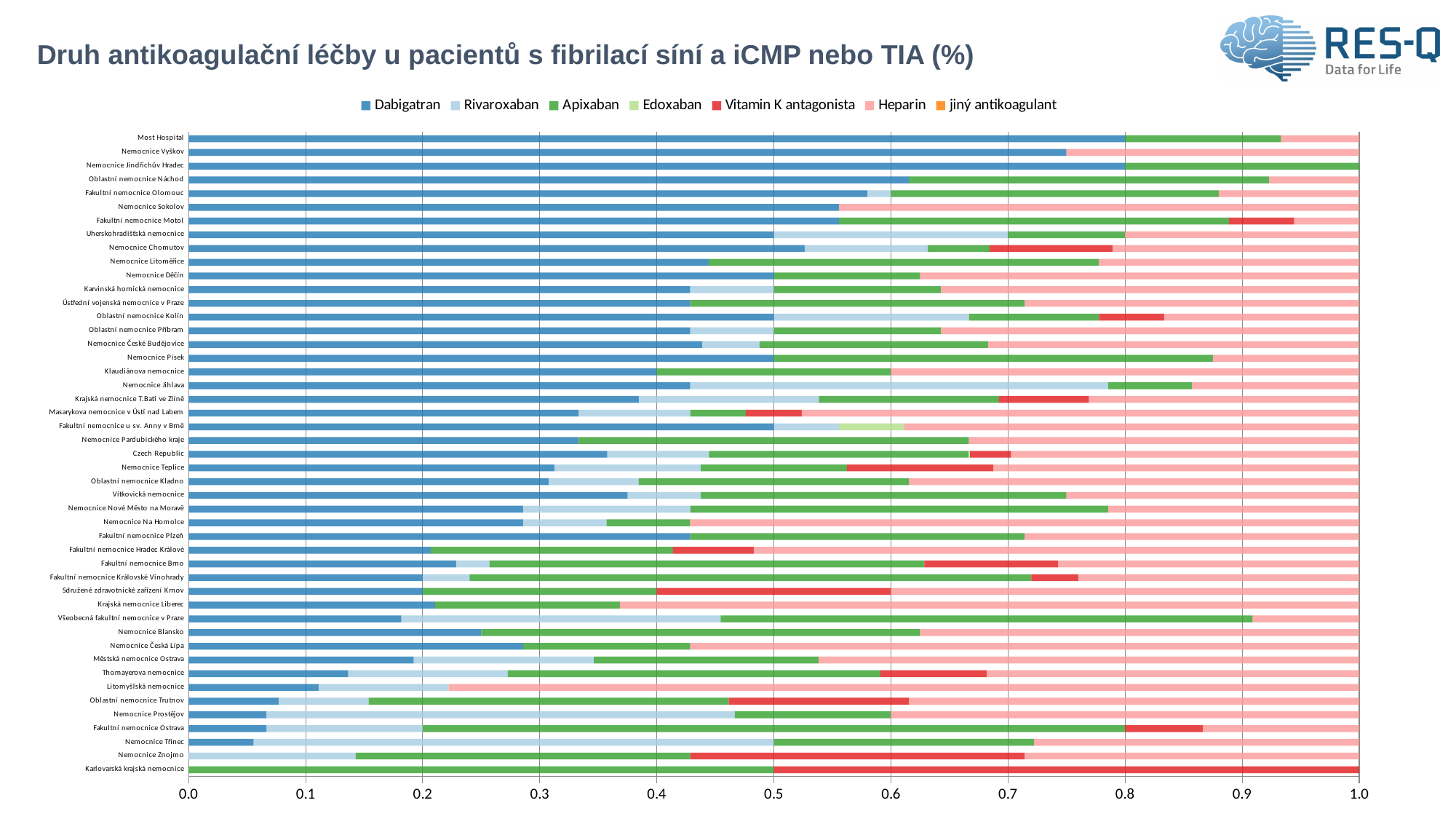
What is the Dabigatran value for Nemocnice Jindřichův Hradec? 0.8 What is the title of the chart? Druh antikoagulační léčby u pacientů s fibrilací síní a iCMP nebo TIA (%) Which series is listed first in the legend? Dabigatran Which hospital has the largest Vitamin K antagonista share? Karlovarská krajská nemocnice How many series does the legend list? 7 Is the Dabigatran value for Nemocnice Třinec greater or less than 0.1? less What kind of chart is shown on the slide? Stacked horizontal bar chart What is the Apixaban value for Karlovarská krajská nemocnice? 0.5 Which has the larger Dabigatran share, Most Hospital or Nemocnice Znojmo? Most Hospital What is the Dabigatran value for Most Hospital? 0.8 Is the Dabigatran value for Nemocnice Vyškov greater or less than 0.7? greater